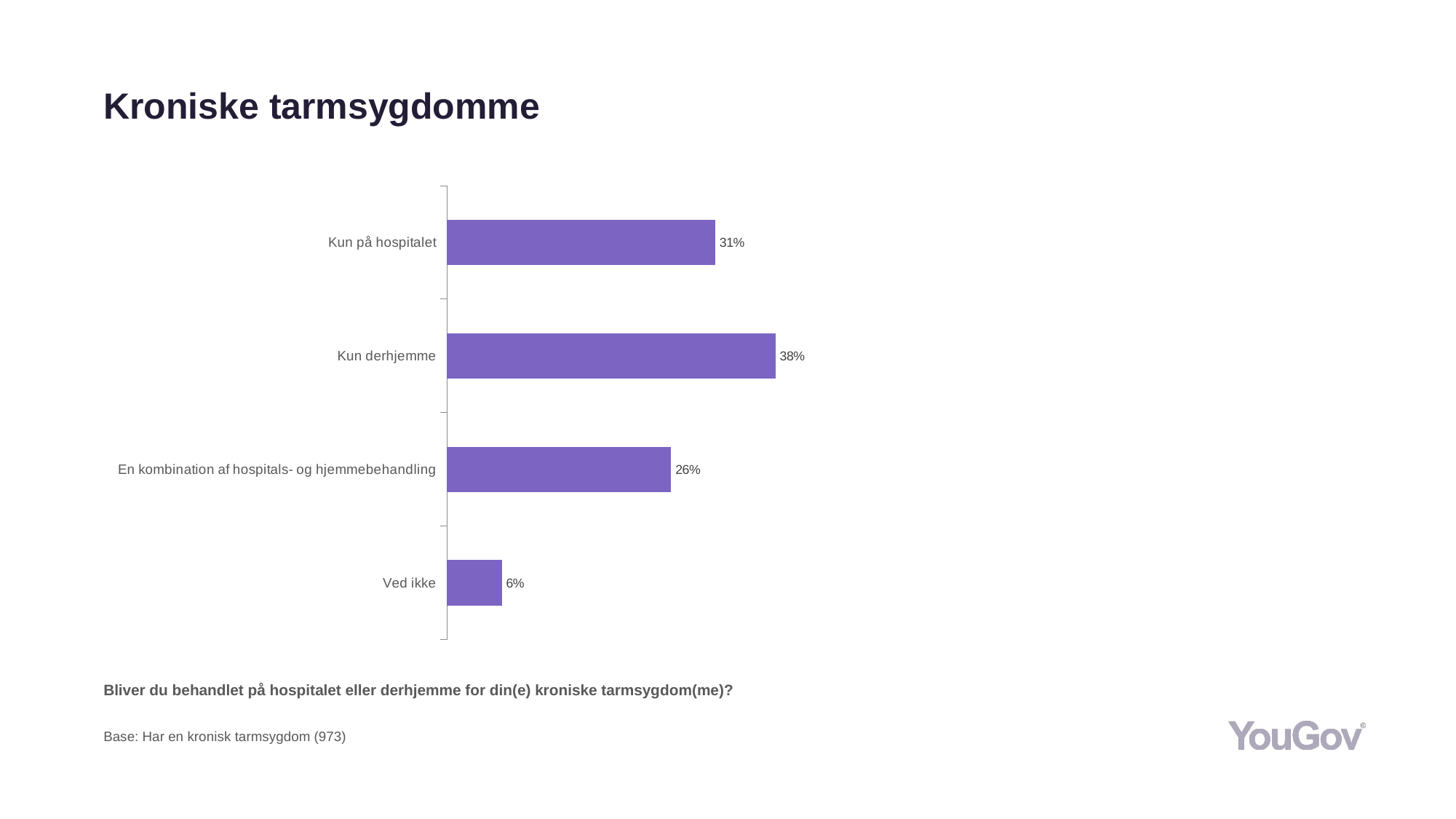
What percentage is shown for "Kun derhjemme"? 38% Which category has the highest value? Kun derhjemme Which category has the lowest value? Ved ikke What percentage is shown for "Ved ikke"? 6% What is the base size stated below the chart? 973 Which is larger: the value for "Kun på hospitalet" or the value for "En kombination af hospitals- og hjemmebehandling"? Kun på hospitalet What percentage is shown for "Kun på hospitalet"? 31% What is the difference between the values for "Kun derhjemme" and "Kun på hospitalet"? 7 percentage points What percentage is shown for "En kombination af hospitals- og hjemmebehandling"? 26% What is the difference between the values for "Kun på hospitalet" and "Ved ikke"? 25 percentage points What kind of chart is shown on the slide? Bar chart How many categories are shown in the chart? 4